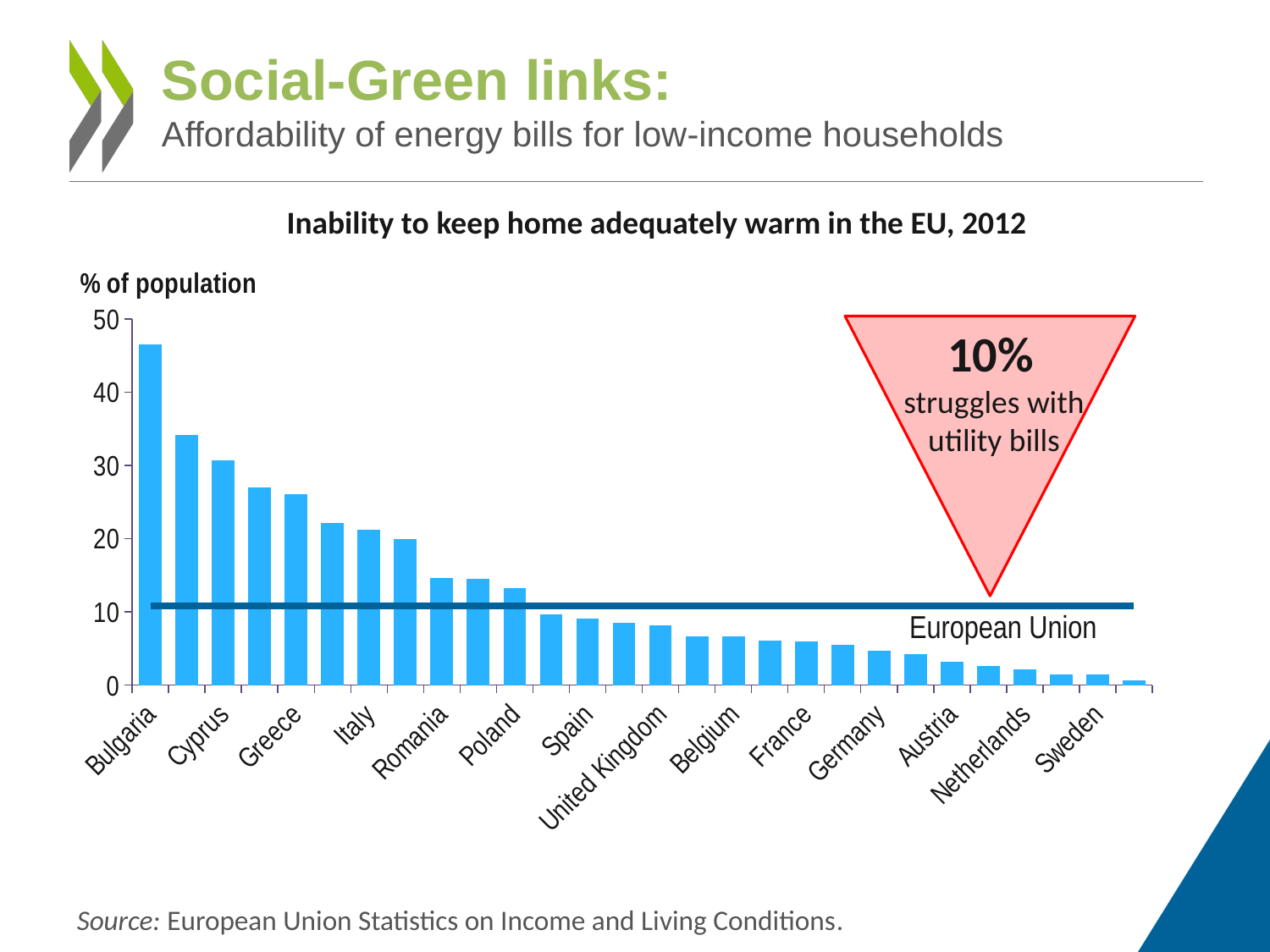
Which country has the highest value in the chart? Bulgaria What is the title of the chart? Inability to keep home adequately warm in the EU, 2012 Which has a higher value, Italy or Spain? Italy Is the value for Sweden greater or less than 10? less Do the bar values rise or fall moving from left to right along the x axis? fall Is the value for Spain greater or less than 10? less What type of chart is shown on the slide? bar chart What is the label on the vertical axis of the chart? % of population Is the value for Bulgaria greater or less than 40? greater